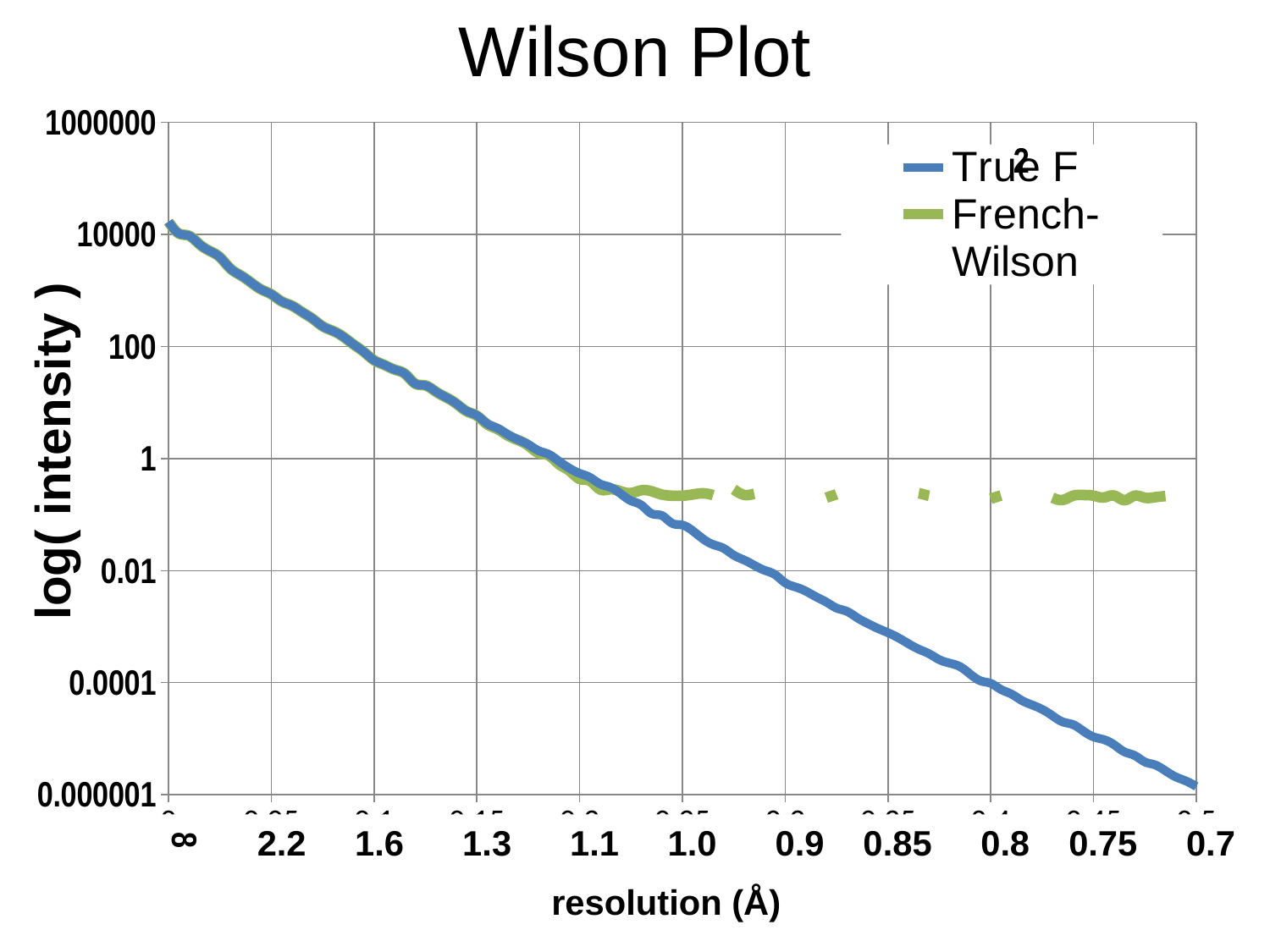
Is the value for French-Wilson at resolution 0.75 Å greater or less than 1? less At resolution 0.8 Å, which series has the higher value, True F² or French-Wilson? French-Wilson Is the value for True F² at resolution ∞ greater or less than 100? greater Is the value for True F² at resolution 0.7 Å greater or less than 0.01? less What is the title of the chart? Wilson Plot Does the True F² series rise or fall from left to right along the x axis? Fall What is the label of the x axis? resolution (Å) What kind of chart is shown on the slide? Line chart How many series does the legend list? 2